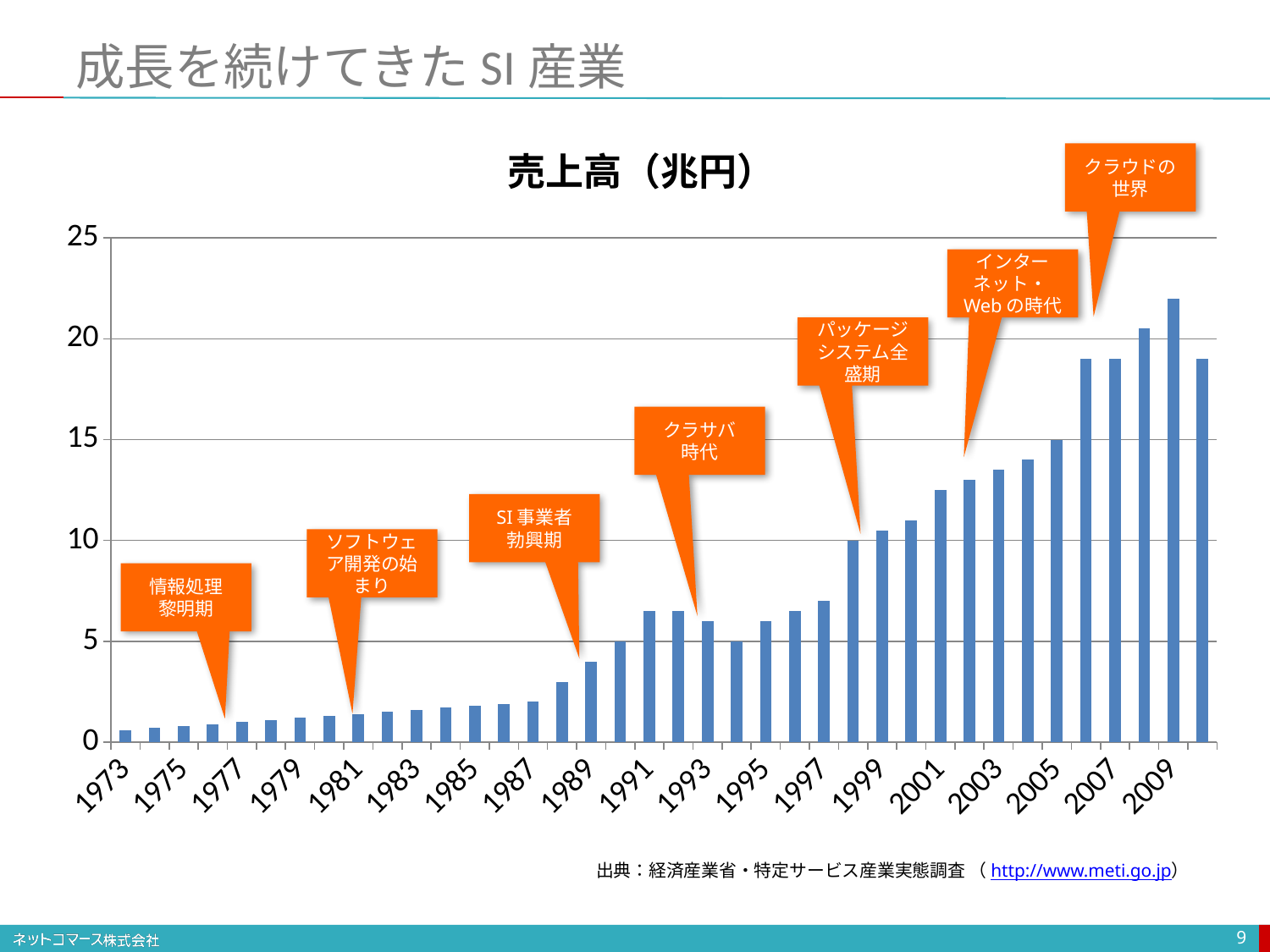
Is the value for 1989 greater or less than 5? less Is the value for 2009 greater or less than 20? greater Do the values generally rise or fall from 1973 to 2009? rise Which is larger, the value for 2009 or the value for 2010? 2009 Which is larger, the value for 1991 or the value for 1985? 1991 What is the title of the chart? 売上高（兆円） Is the value for 2007 greater or less than 15? greater Which year has the lowest value in the chart? 1973 What kind of chart is shown on the slide? bar chart Which year has the highest value in the chart? 2009